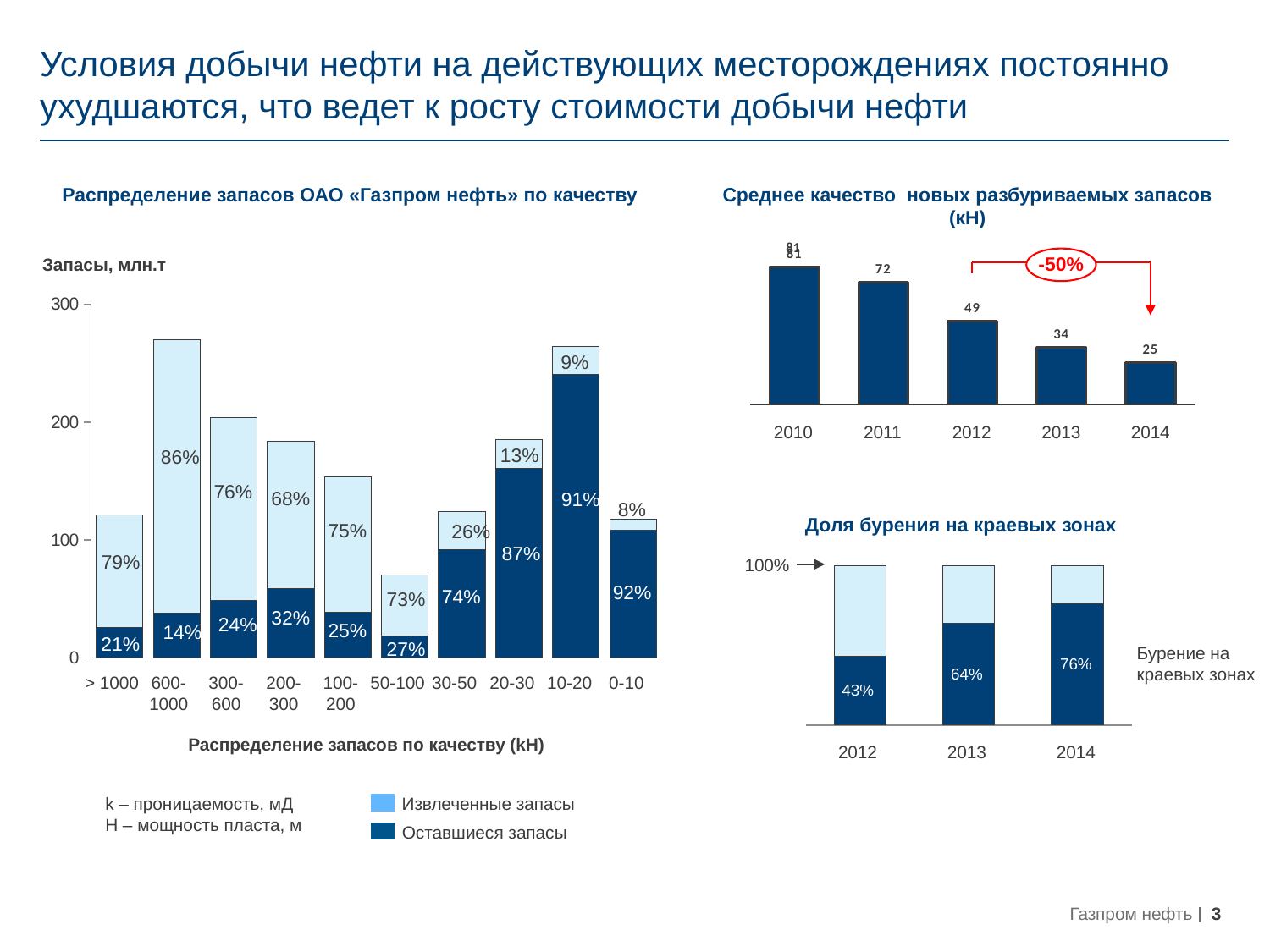
How many quality categories are shown on the x axis of the chart 'Распределение запасов ОАО «Газпром нефть» по качеству'? 10 In the chart 'Среднее качество новых разбуриваемых запасов (кН)', which year has the highest value? 2010 In the chart 'Среднее качество новых разбуриваемых запасов (кН)', do the values rise or fall from 2010 to 2014? fall In the chart 'Среднее качество новых разбуриваемых запасов (кН)', what is the difference between the 2010 and 2014 values? 56 In the chart 'Распределение запасов ОАО «Газпром нефть» по качеству', is the total reserves value for the 600-1000 category greater or less than 200? greater In the chart 'Среднее качество новых разбуриваемых запасов (кН)', what is the value for 2012? 49 How many series does the legend of the chart 'Распределение запасов ОАО «Газпром нефть» по качеству' list? 2 In the chart 'Доля бурения на краевых зонах', what is the share of drilling in edge zones in 2013? 64% In the chart 'Распределение запасов ОАО «Газпром нефть» по качеству', what percentage of the 600-1000 category is extracted reserves (Извлеченные запасы)? 86% In the chart 'Распределение запасов ОАО «Газпром нефть» по качеству', what percentage of the 0-10 category is remaining reserves (Оставшиеся запасы)? 92% In the chart 'Среднее качество новых разбуриваемых запасов (кН)', which year has the lowest value? 2014 In the chart 'Доля бурения на краевых зонах', by how many percentage points did the share increase from 2012 to 2014? 33 percentage points